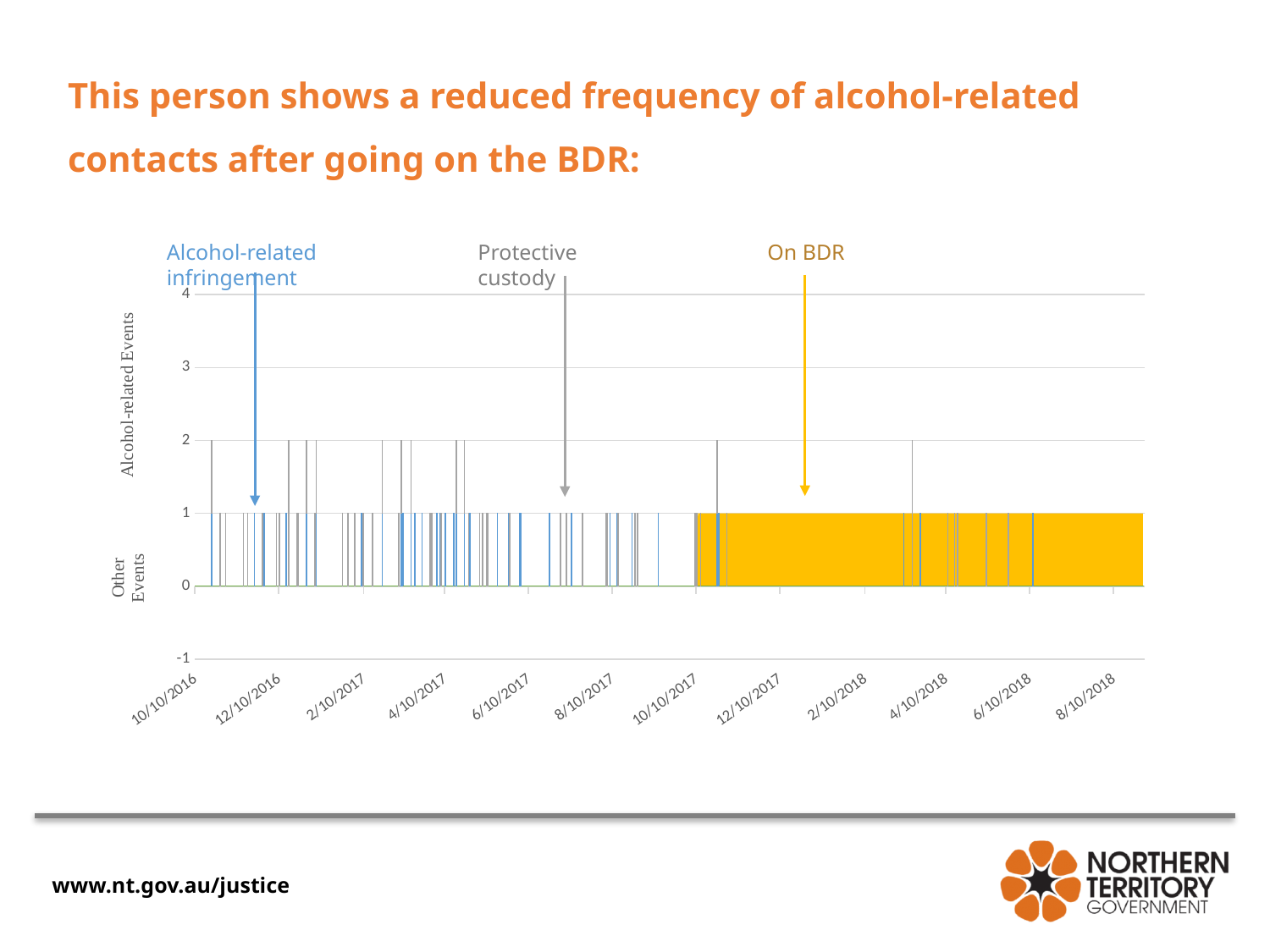
What kind of chart is shown on the slide? bar chart What colour marks the alcohol-related infringement events in the chart? blue How many annotated event types are labelled with arrows above the chart? 3 How many date labels are shown along the x axis? 12 What is the first date label on the x axis? 10/10/2016 What is the highest value shown on the y axis of the chart? 4 Does the frequency of alcohol-related events rise or fall after the person goes on the BDR? fall What colour is used to shade the On BDR period in the chart? yellow What is the lowest value shown on the y axis of the chart? -1 What is the height of the tallest bars in the chart? 2 What is the last date label on the x axis? 8/10/2018